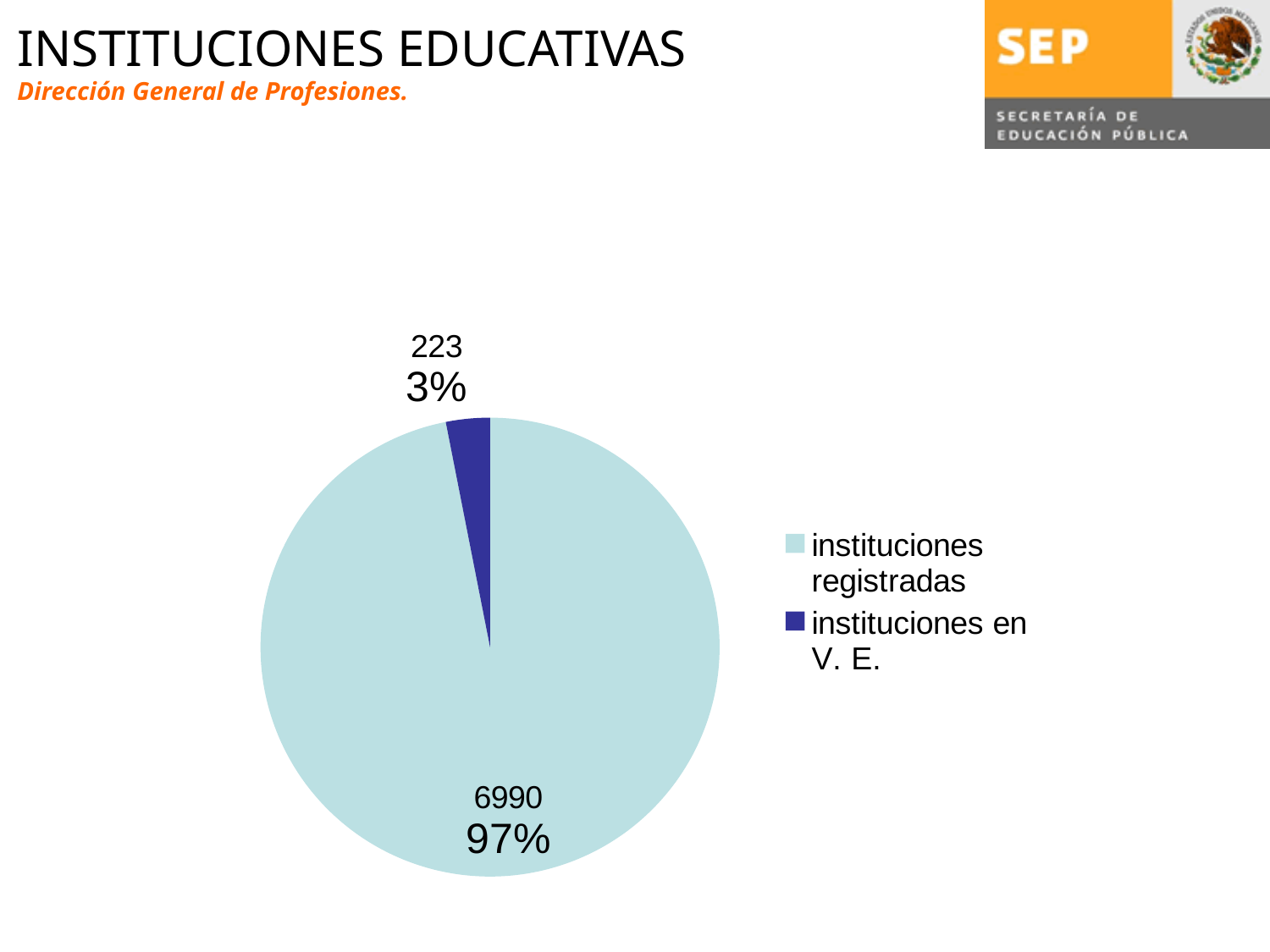
How many categories does the pie chart have? 2 What share of the pie does instituciones registradas represent? 97% What share of the pie does instituciones en V. E. represent? 3% What is the difference between the values for instituciones registradas and instituciones en V. E.? 6767 Which category has the largest slice of the pie? instituciones registradas What is the value for instituciones registradas? 6990 What kind of chart is shown on the slide? pie chart Which is larger, instituciones registradas or instituciones en V. E.? instituciones registradas What colour is the slice for instituciones en V. E.? dark blue Which category has the smallest slice of the pie? instituciones en V. E. What is the value for instituciones en V. E.? 223 What is the total of the two values shown in the pie chart? 7213